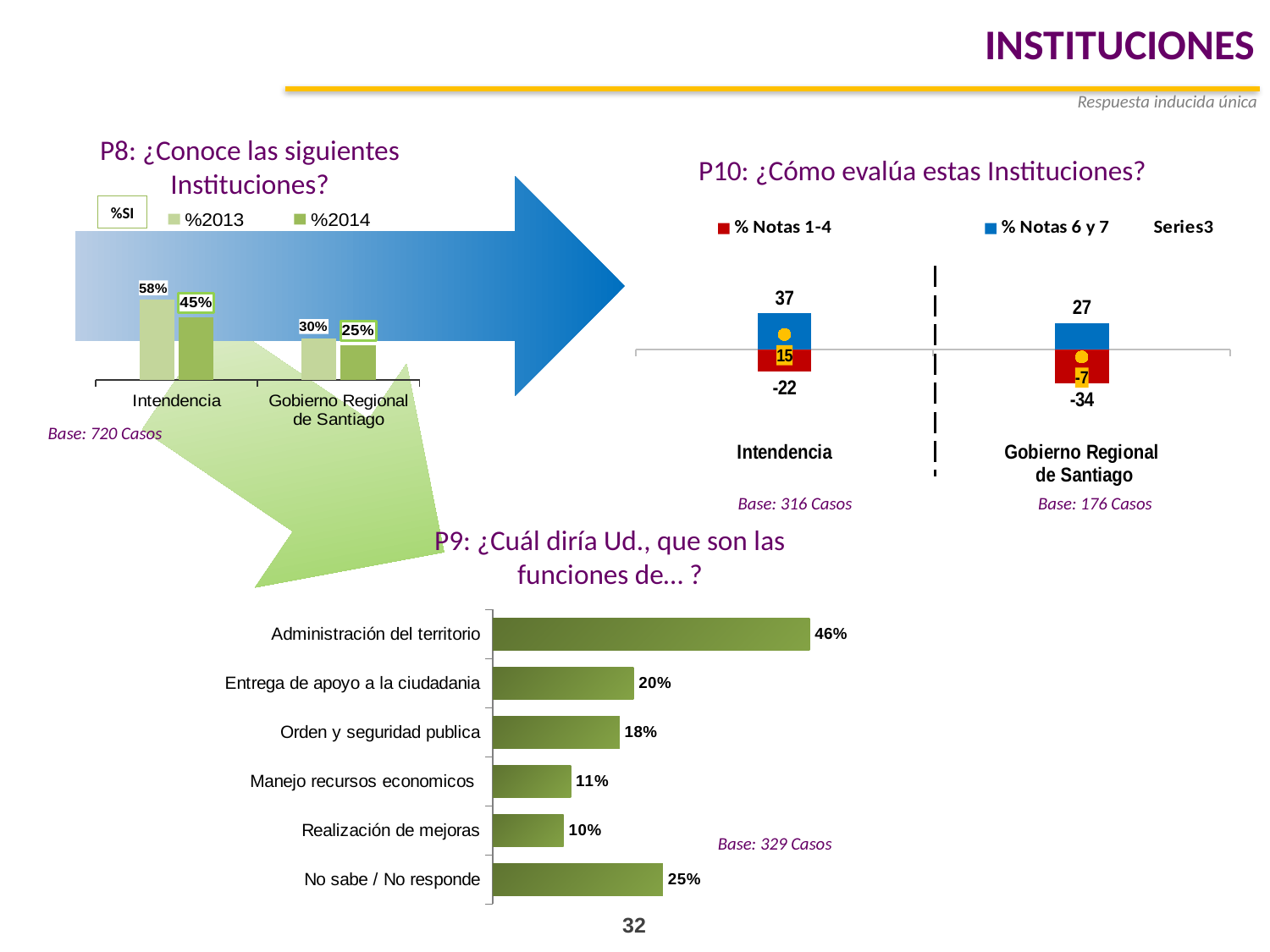
In the P10 chart (¿Cómo evalúa estas Instituciones?), which institution has the higher % Notas 6 y 7 value, Intendencia or Gobierno Regional de Santiago? Intendencia In the P9 chart (¿Cuál diría Ud., que son las funciones de...?), which category has the lowest value? Realización de mejoras In the P9 chart (¿Cuál diría Ud., que son las funciones de...?), which category has the highest value? Administración del territorio In the P9 chart (¿Cuál diría Ud., que son las funciones de...?), how many categories are shown? 6 In the P8 chart (¿Conoce las siguientes Instituciones?), how many series does the legend list? 2 In the P9 chart (¿Cuál diría Ud., que son las funciones de...?), what is the value for Orden y seguridad publica? 18% In the P10 chart (¿Cómo evalúa estas Instituciones?), what is the % Notas 6 y 7 value for Intendencia? 37 In the P8 chart (¿Conoce las siguientes Instituciones?), what is the difference between the %2013 and %2014 values for Intendencia? 13% In the P10 chart (¿Cómo evalúa estas Instituciones?), what is the % Notas 1-4 value for Gobierno Regional de Santiago? -34 What kind of chart is the P9 chart (¿Cuál diría Ud., que son las funciones de...?)? Bar chart In the P8 chart (¿Conoce las siguientes Instituciones?), what is the %2013 value for Intendencia? 58% In the P8 chart (¿Conoce las siguientes Instituciones?), what is the %2014 value for Gobierno Regional de Santiago? 25%